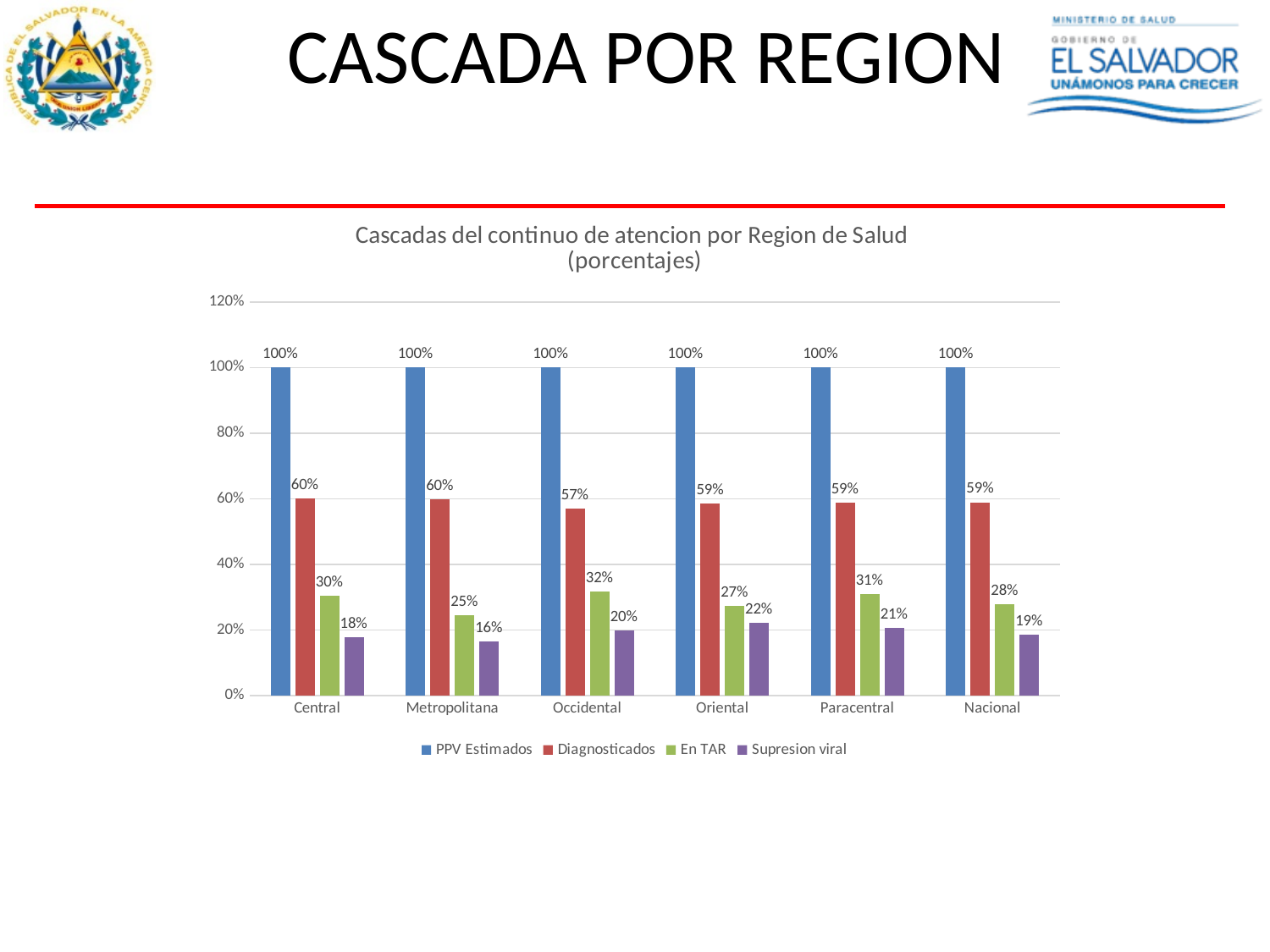
How many regions (categories) are shown on the x axis? 6 Which region has the highest En TAR value? Occidental What is the Supresion viral value for Metropolitana? 16% What kind of chart is shown on the slide? Bar chart How many series does the legend list? 4 What is the Diagnosticados value for Nacional? 59% Which series is shown in purple in the legend? Supresion viral What is the title of the chart? Cascadas del continuo de atencion por Region de Salud (porcentajes) What is the difference between the Diagnosticados and En TAR values for Central? 30% What is the value for En TAR in the Occidental region? 32% Which is larger, the Supresion viral value for Oriental or for Paracentral? Oriental Which region has the lowest Supresion viral value? Metropolitana